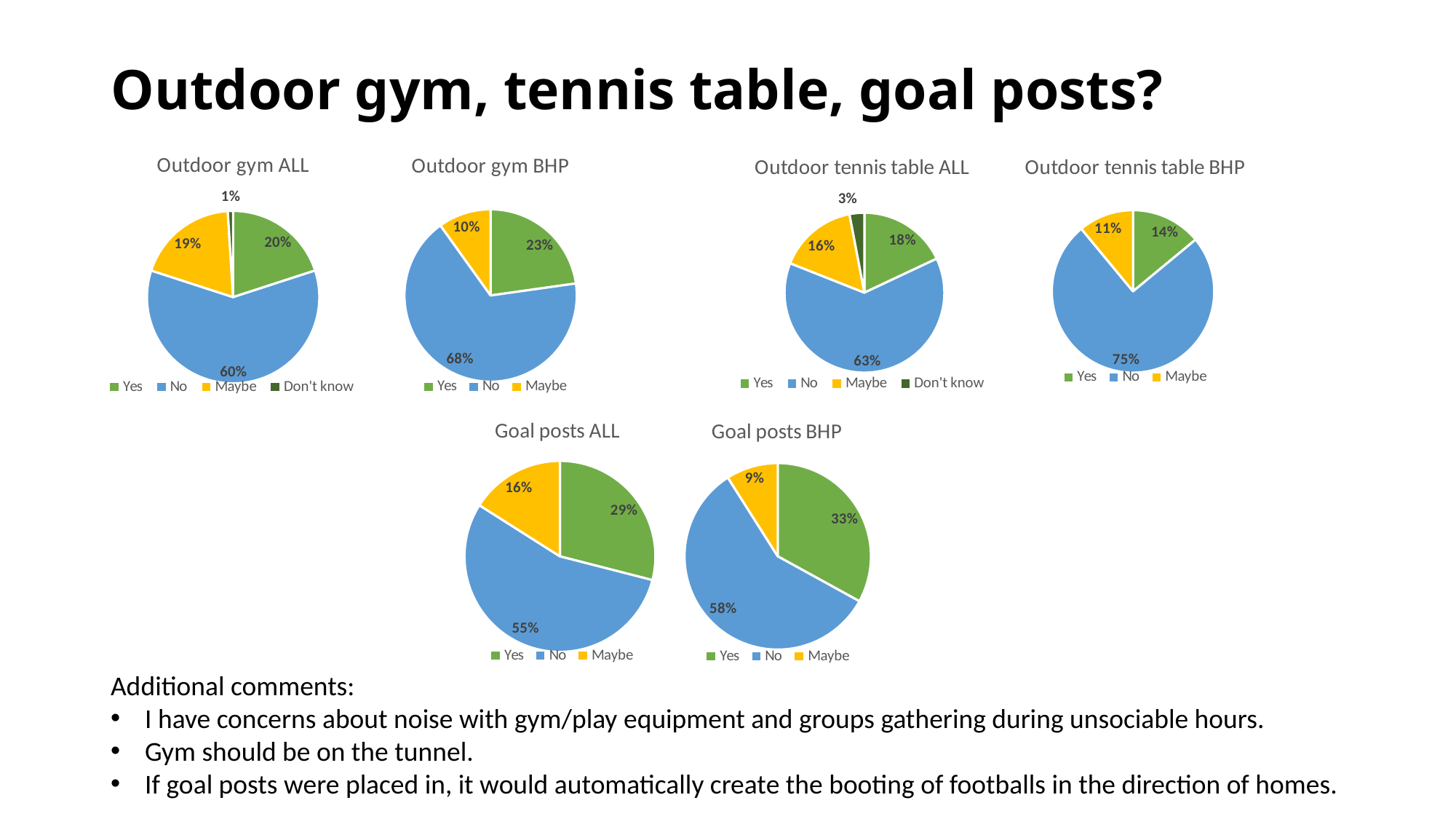
In the 'Outdoor gym ALL' chart, what percentage answered No? 60% How many pie charts are shown on the slide? 6 What type of chart is 'Goal posts BHP'? Pie chart In the 'Outdoor gym BHP' chart, what percentage answered Maybe? 10% How many categories does the legend of the 'Outdoor tennis table ALL' chart list? 4 In the 'Outdoor tennis table BHP' chart, what percentage answered Yes? 14% In the 'Goal posts ALL' chart, what is the difference between the Yes and Maybe shares? 13% In the 'Goal posts ALL' chart, which response has the largest share? No In the 'Outdoor gym ALL' chart, which response has the smallest share? Don't know In the 'Goal posts BHP' chart, what percentage answered No? 58% In the 'Outdoor tennis table BHP' chart, which is larger, the Yes share or the Maybe share? Yes In the 'Outdoor tennis table ALL' chart, what percentage answered Don't know? 3%